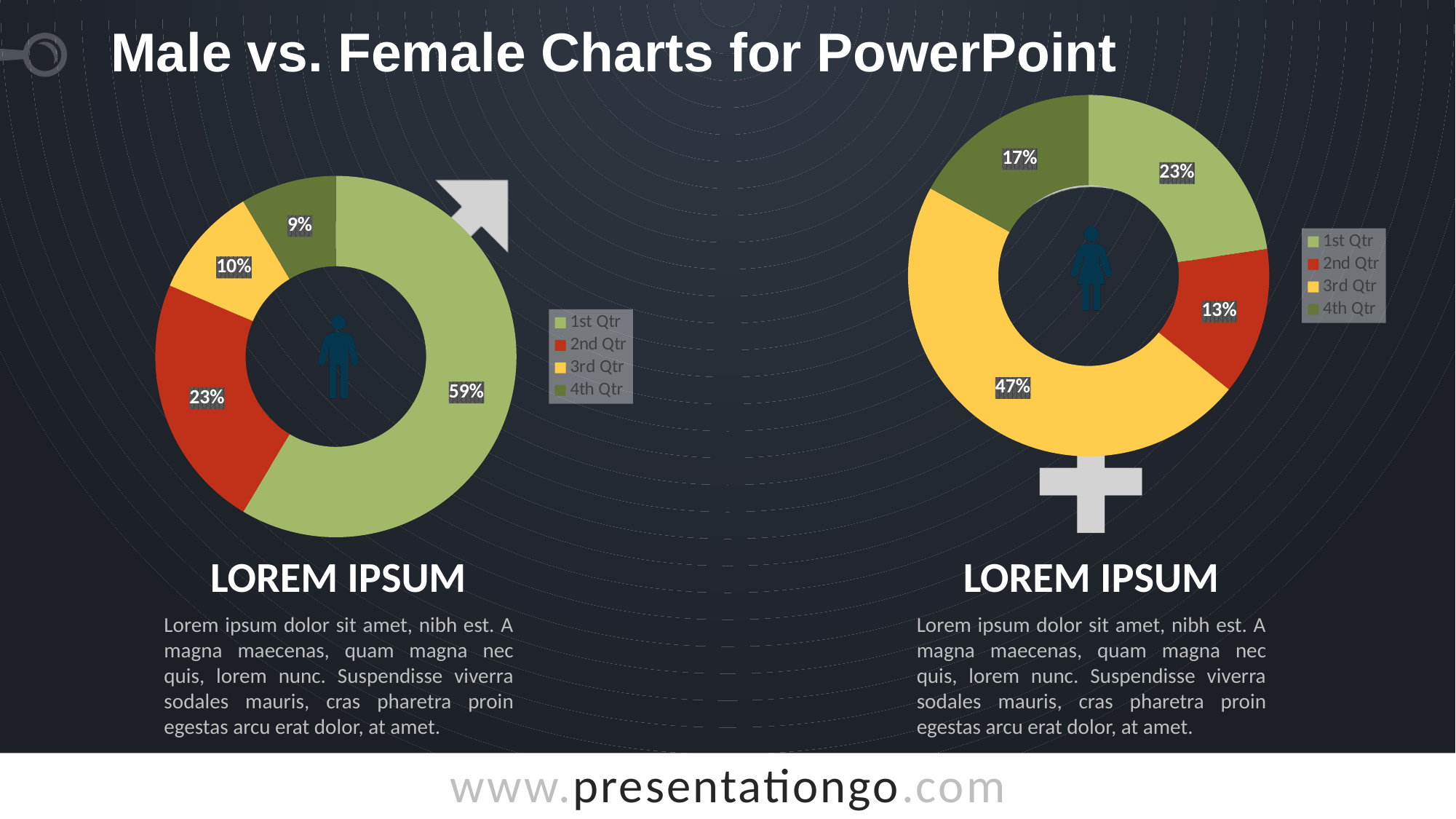
Which chart has the larger value for 4th Qtr, the left (male) chart or the right (female) chart? the right (female) chart What type of chart is the right (female) chart? doughnut chart In the right (female) doughnut chart, what colour represents 3rd Qtr? yellow In the left (male) doughnut chart, what is the value for 1st Qtr? 59% In the right (female) doughnut chart, which quarter has the smallest share? 2nd Qtr In the left (male) doughnut chart, what is the value for 3rd Qtr? 10% In the right (female) doughnut chart, what is the difference between the 3rd Qtr and 1st Qtr values? 24% In the left (male) doughnut chart, which quarter has the largest share? 1st Qtr In the right (female) doughnut chart, what is the value for 3rd Qtr? 47% How many categories does the legend of the left (male) doughnut chart list? 4 In the left (male) doughnut chart, what is the difference between the 1st Qtr and 2nd Qtr values? 36% In the right (female) doughnut chart, what is the value for 2nd Qtr? 13%